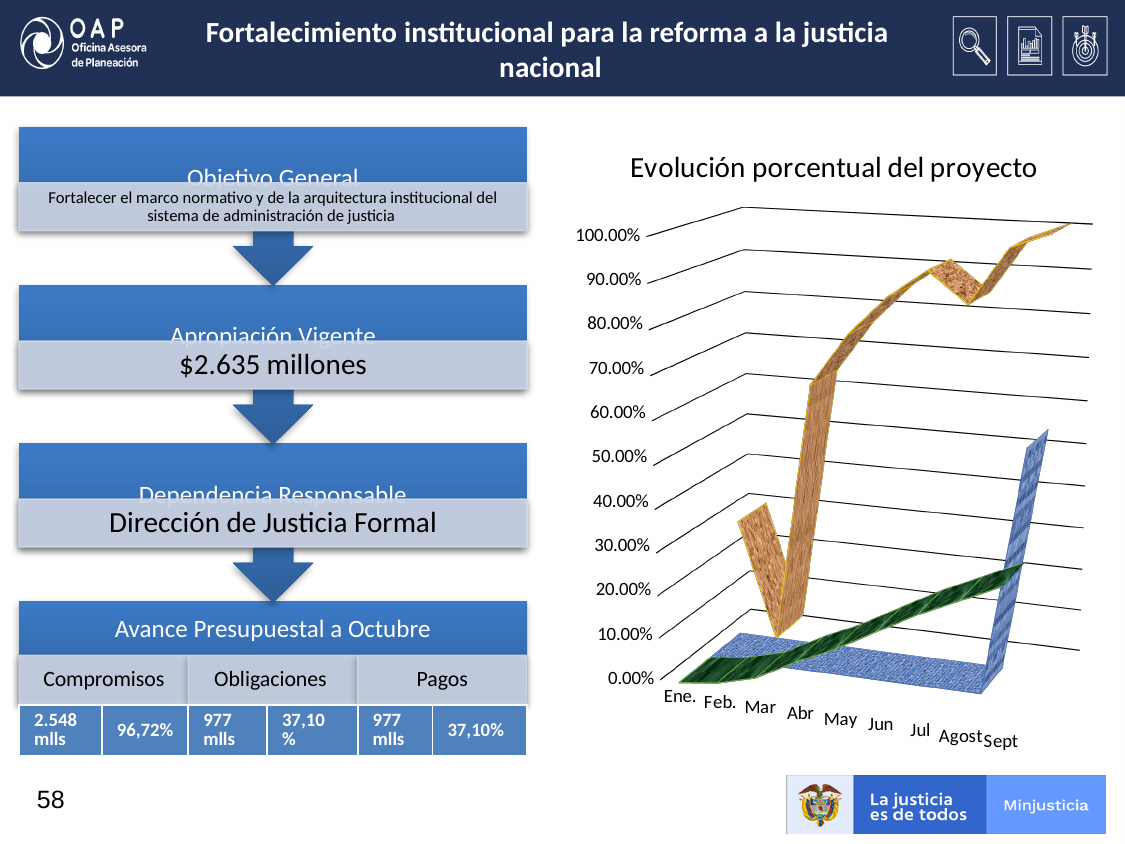
What is the first category on the x axis of the "Evolución porcentual del proyecto" chart? Ene. How many months are shown on the x axis of the "Evolución porcentual del proyecto" chart? 9 What is the highest tick value shown on the vertical axis of the "Evolución porcentual del proyecto" chart? 100.00% In the "Evolución porcentual del proyecto" chart, is the value of the orange series at Sept greater or less than 50.00%? greater What is the title of the chart on the right side of the slide? Evolución porcentual del proyecto In the "Evolución porcentual del proyecto" chart, does the green series rise or fall from Ene. to Sept? rise In the "Evolución porcentual del proyecto" chart, is the value of the green series at Ene. greater or less than 20.00%? less In the "Evolución porcentual del proyecto" chart, does the orange series generally rise or fall from Mar to Sept? rise What kind of chart is "Evolución porcentual del proyecto"? line chart